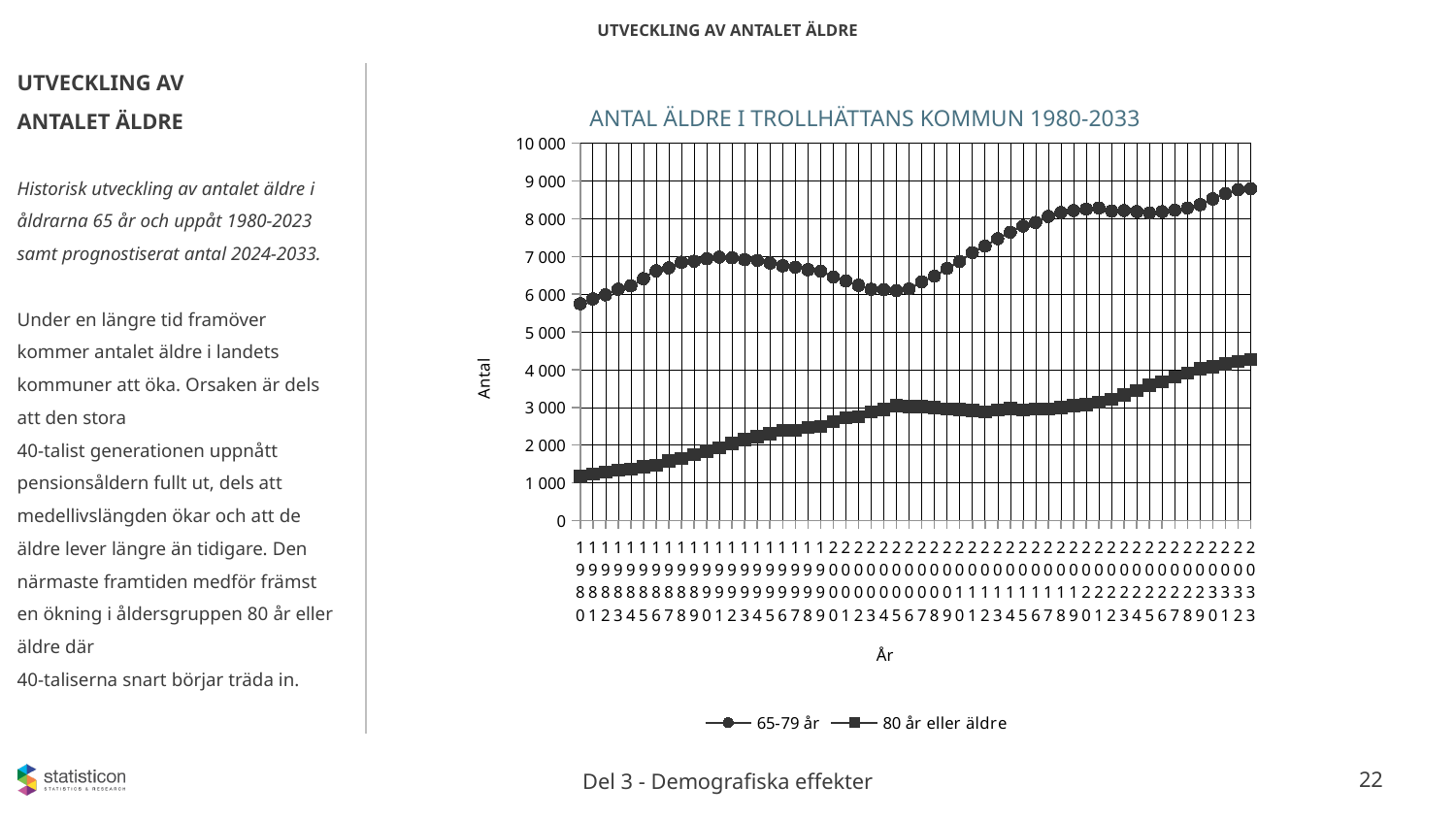
How many years (data points per series) are plotted on the x axis? 54 What kind of chart is shown on the slide? Line chart In which year is the 80 år eller äldre series at its lowest? 1980 Is the value for 80 år eller äldre in 2033 greater or less than 4 000? greater What is the title of the chart? ANTAL ÄLDRE I TROLLHÄTTANS KOMMUN 1980-2033 In 2033, which series has the larger value, 65-79 år or 80 år eller äldre? 65-79 år Does the 80 år eller äldre series rise or fall overall from 1980 to 2033? Rise Is the value for 80 år eller äldre in 1980 greater or less than 2 000? less Is the value for 65-79 år in 2033 greater or less than 8 000? greater What are the two series named in the legend? 65-79 år and 80 år eller äldre How many series does the legend list? 2